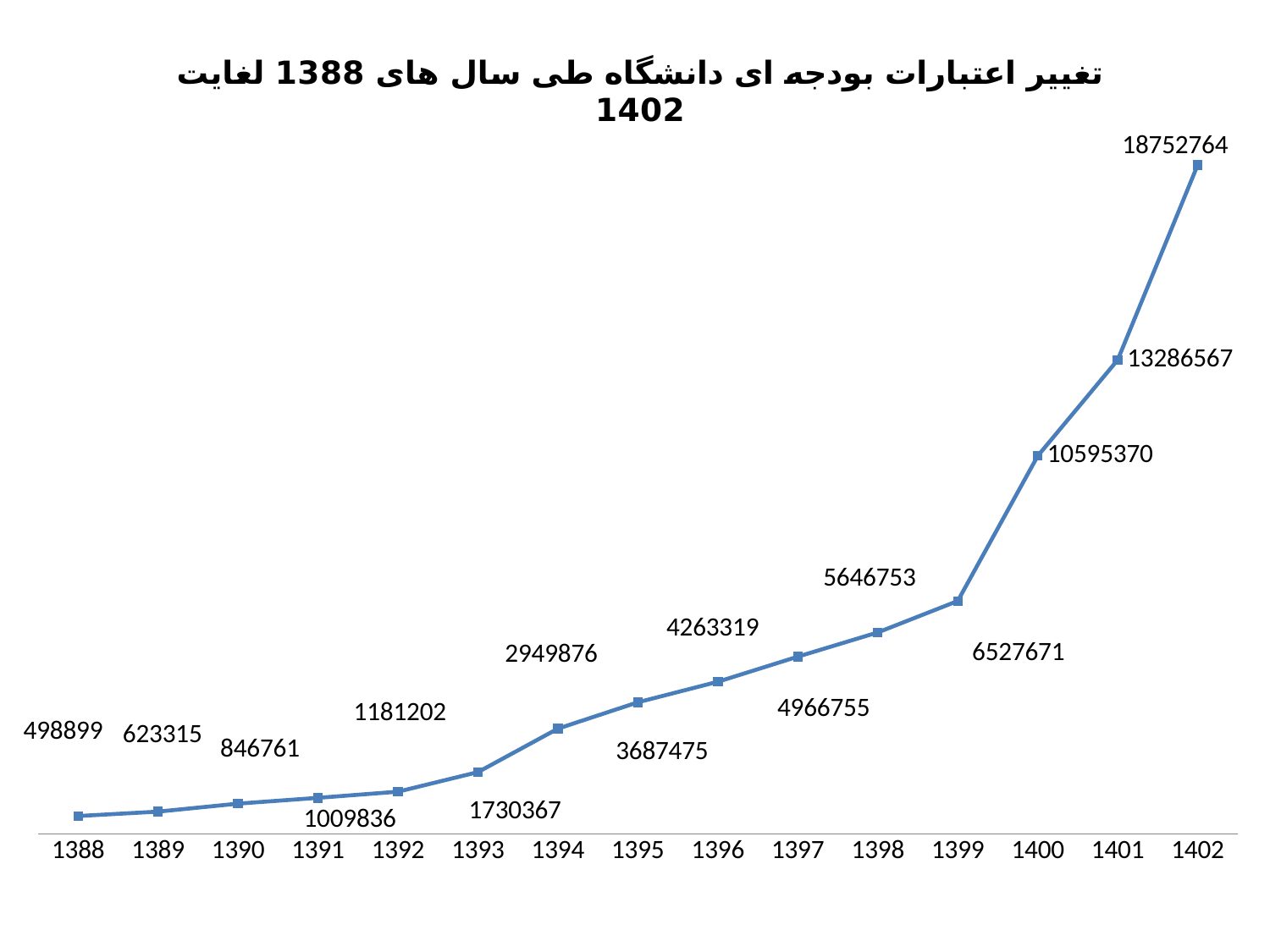
Do the values rise or fall from 1388 to 1402? rise What is the value for the year 1388? 498899 How many years are plotted on the x axis? 15 Which year has the highest value? 1402 What is the difference between the values for 1402 and 1401? 5466197 Which year has the lowest value? 1388 What is the value for the year 1402? 18752764 What is the difference between the values for 1389 and 1388? 124416 What is the value for the year 1394? 2949876 Which is larger, the value for 1399 or the value for 1400? 1400 What type of chart is shown on the slide? line chart What is the value for the year 1400? 10595370